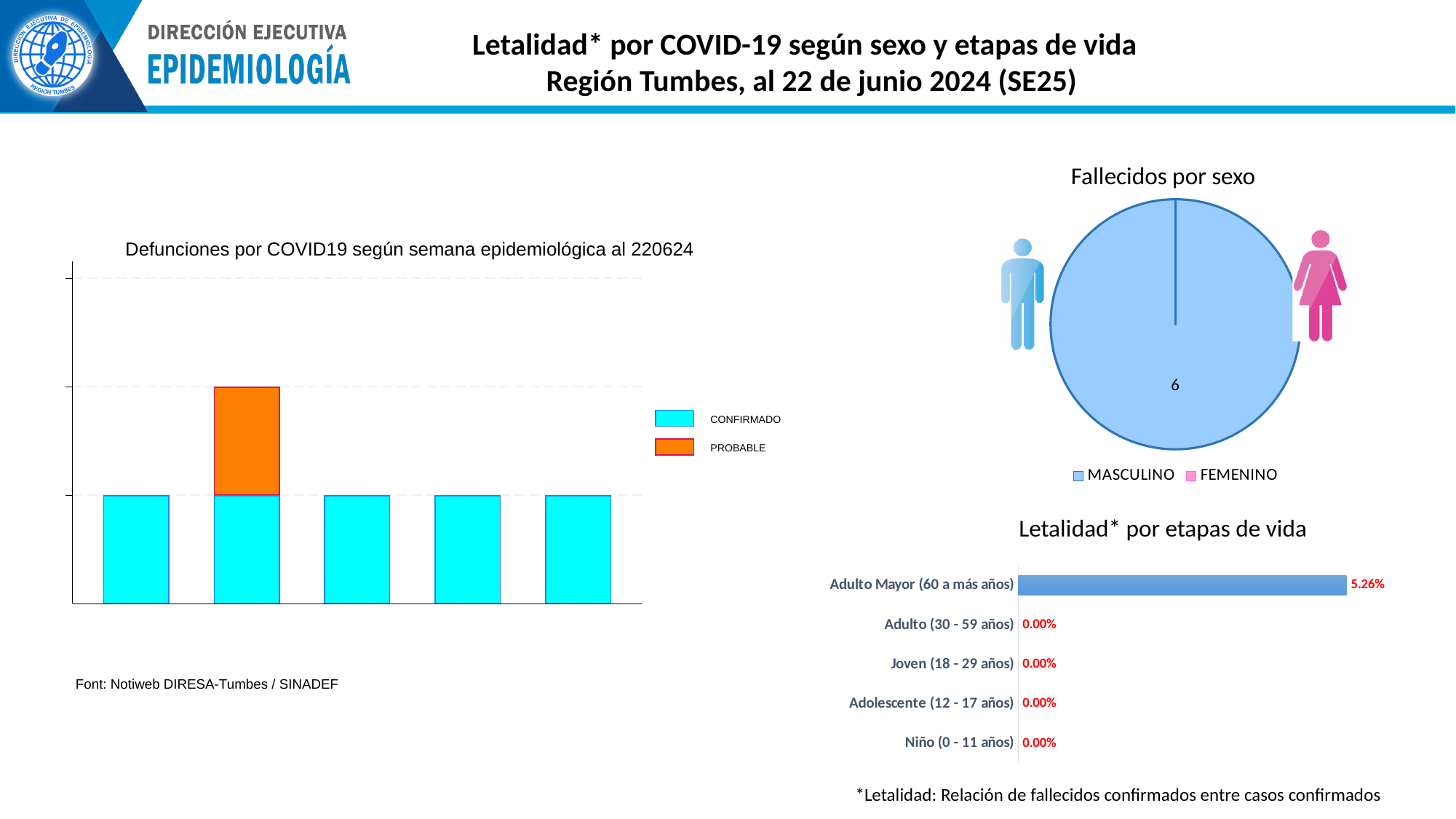
In the 'Fallecidos por sexo' chart, what value is shown for MASCULINO? 6 In the 'Defunciones por COVID19 según semana epidemiológica al 220624' chart, how many bars are plotted? 5 In the 'Letalidad* por etapas de vida' chart, which is larger: the value for Adulto Mayor (60 a más años) or Niño (0 - 11 años)? Adulto Mayor (60 a más años) In the 'Letalidad* por etapas de vida' chart, which age group has the highest value? Adulto Mayor (60 a más años) What kind of chart is 'Fallecidos por sexo'? Pie chart In the 'Letalidad* por etapas de vida' chart, what is the value for Adulto Mayor (60 a más años)? 5.26% In the 'Letalidad* por etapas de vida' chart, how many age groups are shown? 5 In the 'Letalidad* por etapas de vida' chart, what is the value for Adulto (30 - 59 años)? 0.00% What kind of chart is 'Letalidad* por etapas de vida'? Bar chart In the 'Letalidad* por etapas de vida' chart, what is the difference between the values for Adulto Mayor (60 a más años) and Joven (18 - 29 años)? 5.26% What are the two legend entries of the 'Defunciones por COVID19 según semana epidemiológica al 220624' chart? CONFIRMADO and PROBABLE How many entries does the legend of the 'Fallecidos por sexo' chart list? 2